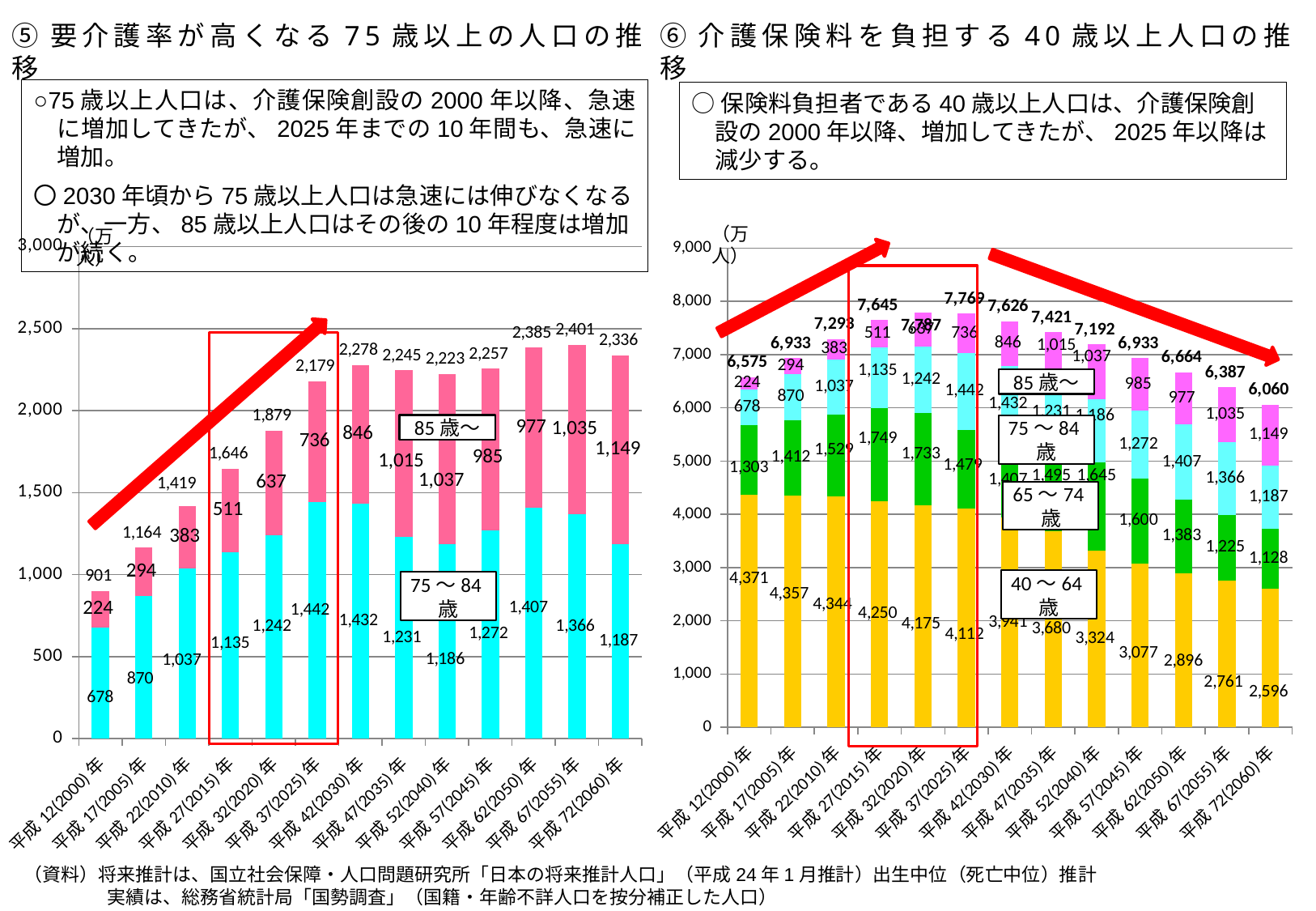
What kind of chart is the right chart (⑥ 40歳以上人口の推移)? stacked bar chart In the right chart (⑥ 40歳以上人口の推移), what is the difference between the 40～64歳 value in 平成12(2000)年 and in 平成72(2060)年? 1,775 In the right chart (⑥ 40歳以上人口の推移), what is the total for 平成32(2020)年? 7,787 In the left chart (⑤ 75歳以上の人口の推移), which year has the lowest total? 平成12(2000)年 In the right chart (⑥ 40歳以上人口の推移), which year has the lowest total? 平成72(2060)年 In the left chart (⑤ 75歳以上の人口の推移), how much larger is the 85歳～ value in 平成72(2060)年 than in 平成12(2000)年? 925 In the right chart (⑥ 40歳以上人口の推移), what is the 40～64歳 value for 平成72(2060)年? 2,596 In the left chart (⑤ 75歳以上の人口の推移), what is the total population for 平成37(2025)年? 2,179 In the right chart (⑥ 40歳以上人口の推移), do the totals rise or fall from 平成37(2025)年 to 平成72(2060)年? fall In the left chart (⑤ 75歳以上の人口の推移), how many years are shown on the x axis? 13 In the left chart (⑤ 75歳以上の人口の推移), which year has the highest total? 平成67(2055)年 In the left chart (⑤ 75歳以上の人口の推移), what is the value of the 85歳～ segment for 平成72(2060)年? 1,149